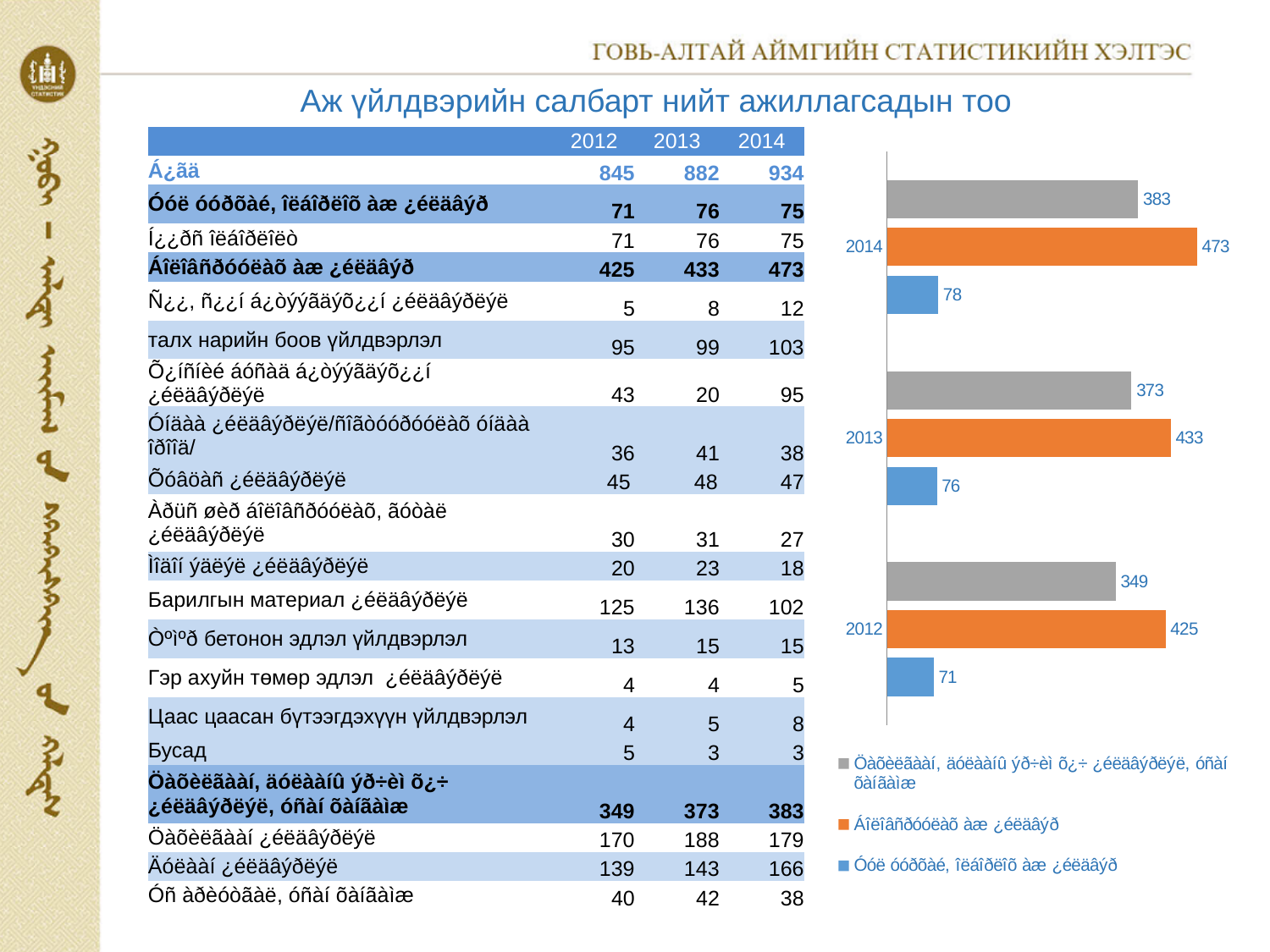
Do the values of the gray series rise or fall from 2012 to 2014? rise What is the value of the blue bar for 2012? 71 What is the difference between the orange bar and the gray bar for 2012? 76 How many year groups are shown on the chart? 3 What is the value of the orange bar for 2014? 473 What kind of chart is shown on the slide? bar chart Which year has the lowest value for the blue series? 2012 What is the difference between the orange bar values for 2014 and 2013? 40 How many series does the legend list? 3 What is the value of the gray bar for 2013? 373 Which is larger, the gray bar for 2014 or the gray bar for 2012? the gray bar for 2014 Which year has the highest value for the orange series? 2014